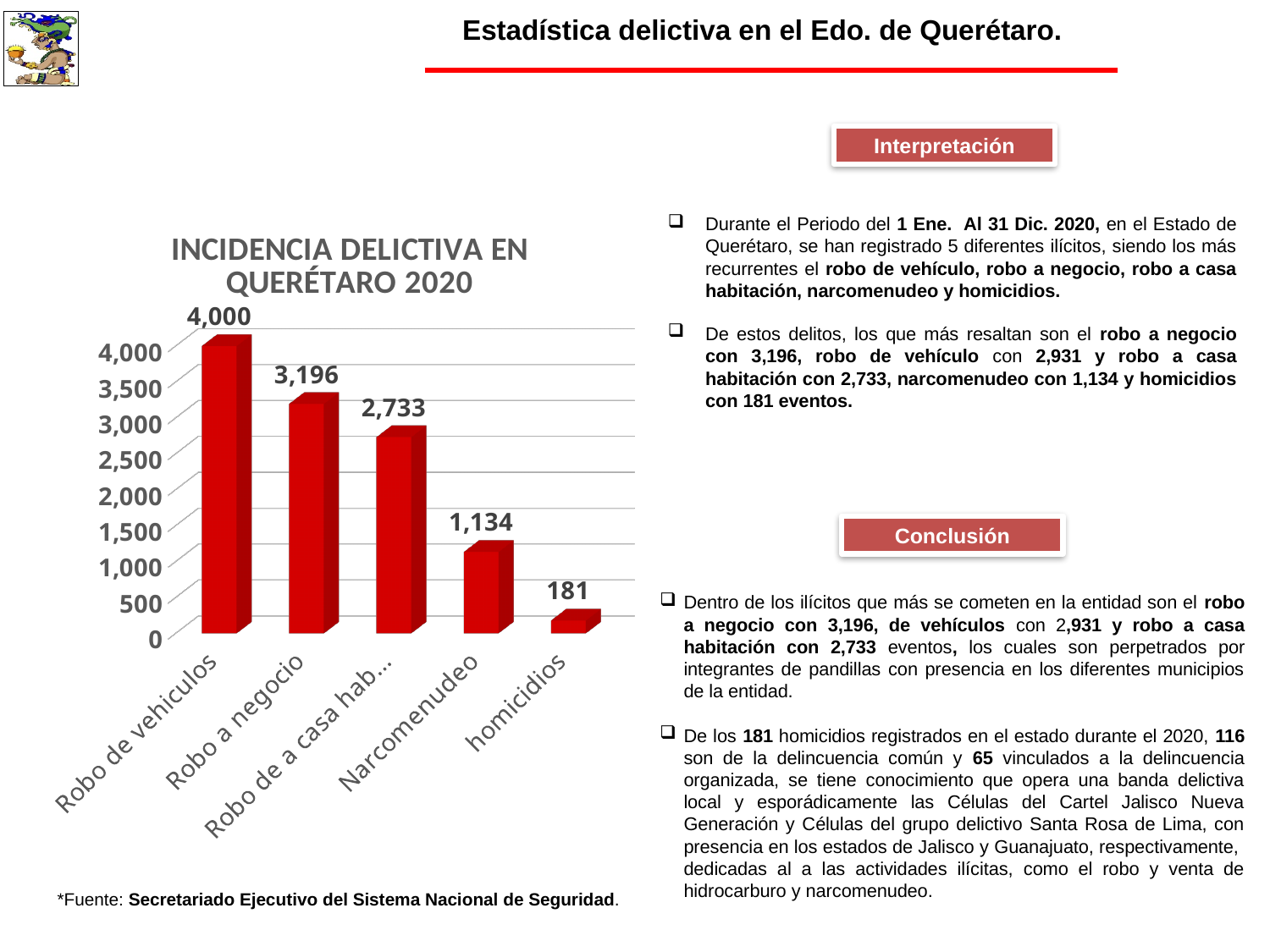
Which is larger, the value for Robo a negocio or the value for Narcomenudeo? Robo a negocio What is the value for Robo de vehiculos? 4,000 What is the value for Robo a negocio? 3,196 How many categories are shown in the chart? 5 Which category has the lowest value? homicidios What is the title of the chart? INCIDENCIA DELICTIVA EN QUERÉTARO 2020 Which category has the highest value? Robo de vehiculos What is the value for homicidios? 181 What is the difference between the values for Robo de vehiculos and Robo a negocio? 804 What is the value for Narcomenudeo? 1,134 What kind of chart is shown? Bar chart What is the difference between the values for Narcomenudeo and homicidios? 953